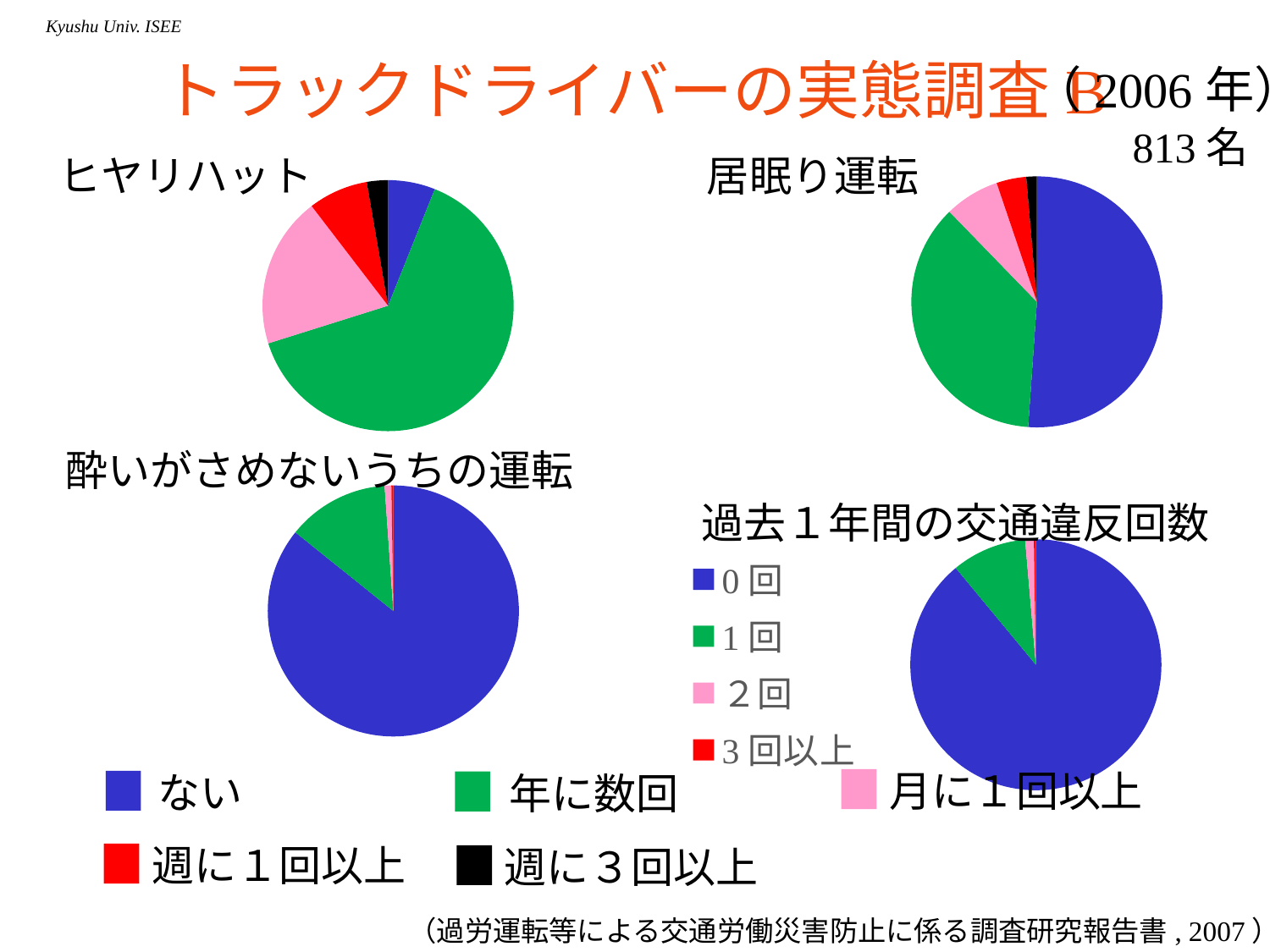
In the 酔いがさめないうちの運転 chart, which slice is larger: 年に数回 or 月に１回以上? 年に数回 In the 居眠り運転 chart, which slice is larger: ない or 年に数回? ない In the 居眠り運転 chart, which category has the smallest slice? 週に３回以上 In the ヒヤリハット chart, which category has the largest slice? 年に数回 How many categories does the legend of the 過去１年間の交通違反回数 chart list? 4 In the 過去１年間の交通違反回数 chart, which category has the largest slice? 0回 What kind of chart is used for ヒヤリハット? pie chart In the 酔いがさめないうちの運転 chart, which category has the largest slice? ない In the 過去１年間の交通違反回数 chart, what colour represents 1回? green In the ヒヤリハット chart, which category has the smallest slice? 週に３回以上 How many categories does the shared legend for the ヒヤリハット, 居眠り運転 and 酔いがさめないうちの運転 charts list? 5